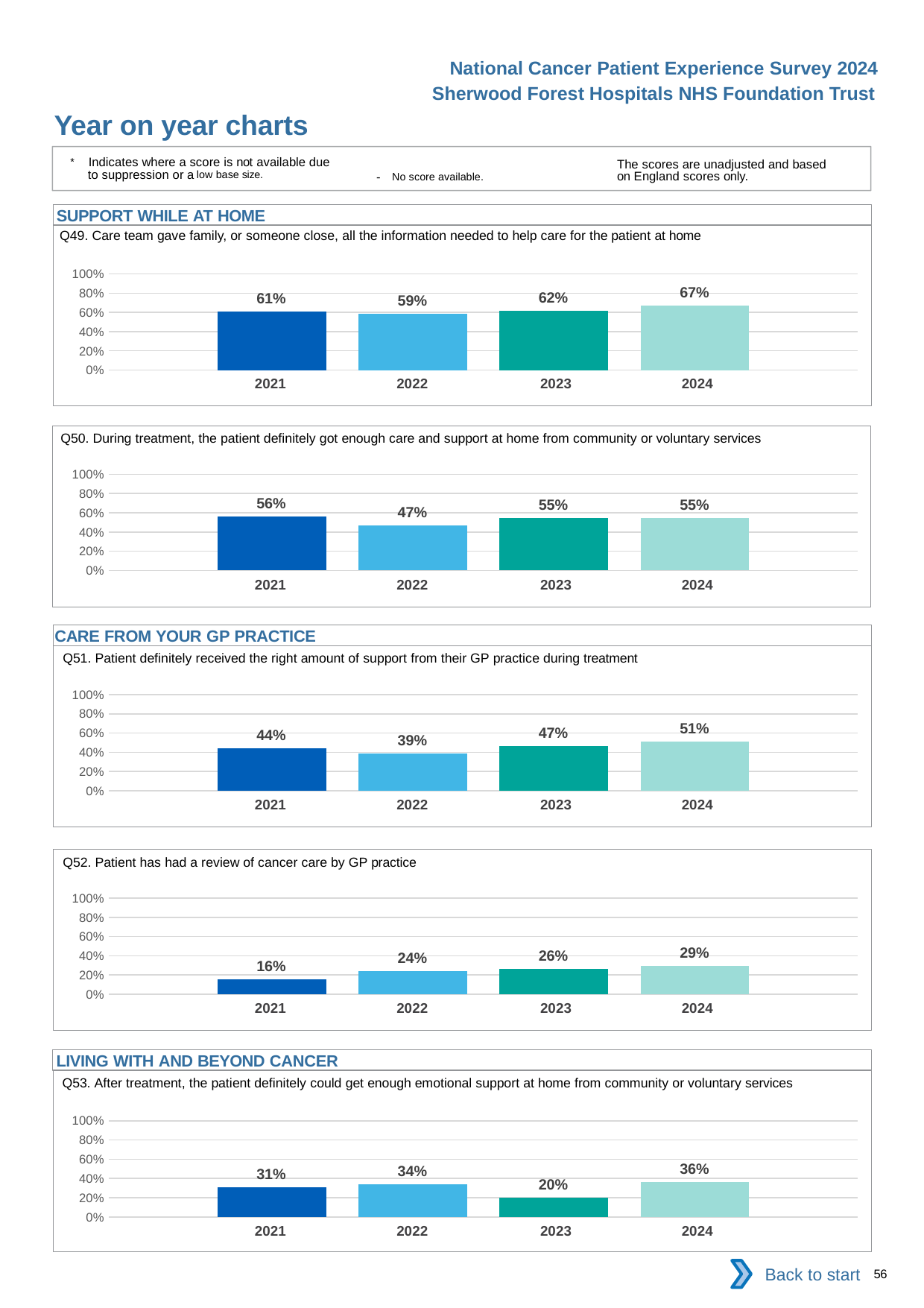
In the Q49 chart, what is the value for 2022? 59% In the Q50 chart, which year has the lowest value? 2022 In the Q52 chart, do the values rise or fall from 2021 to 2024? rise In the Q53 chart, what is the value for 2023? 20% In the Q53 chart, what is the difference between the 2022 and 2023 values? 14% In the Q49 chart, what is the value for 2024? 67% In the Q52 chart, how many years are plotted? 4 In the Q52 chart, which year has the highest value? 2024 In the Q50 chart, is the value for 2021 larger or smaller than the value for 2022? larger In the Q51 chart, what is the difference between the 2024 and 2021 values? 7% Which section heading appears above the Q53 chart? LIVING WITH AND BEYOND CANCER What kind of chart is the Q51 chart? bar chart